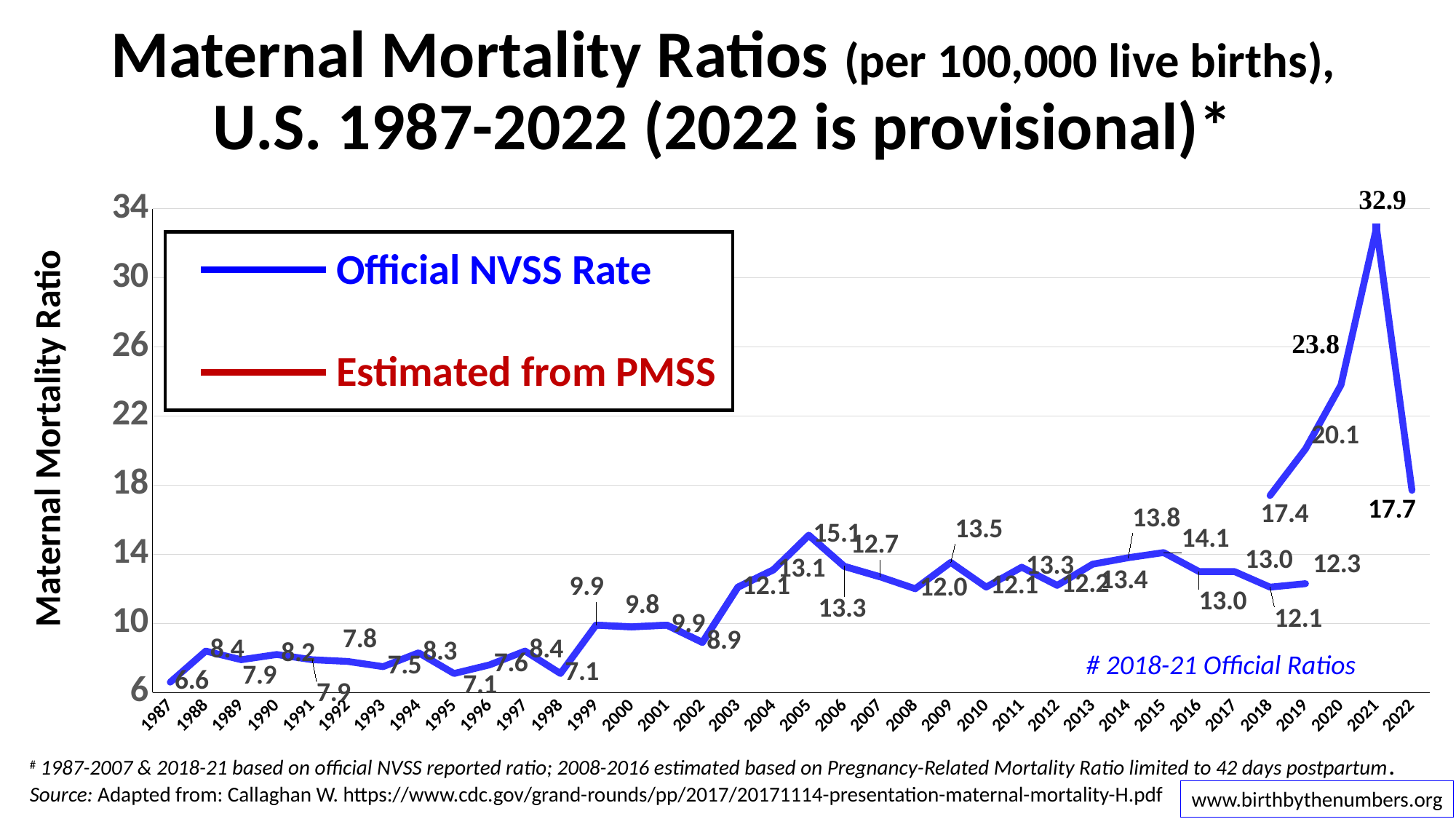
What is the maternal mortality ratio shown for 1987? 6.6 How many series does the legend list? 2 Which year has the lowest maternal mortality ratio on the chart? 1987 Is the value for 2021 greater or less than 30? greater What is the maternal mortality ratio shown for 2022? 17.7 What is the difference between the 2021 value (32.9) and the 2022 value (17.7)? 15.2 What are the two series named in the legend? Official NVSS Rate and Estimated from PMSS What is the maternal mortality ratio shown for 2005? 15.1 What is the maternal mortality ratio shown for 2021? 32.9 What type of chart is shown on the slide? line chart Which is larger, the value for 2005 or the value for 2009? 2005 Which year has the highest maternal mortality ratio on the chart? 2021